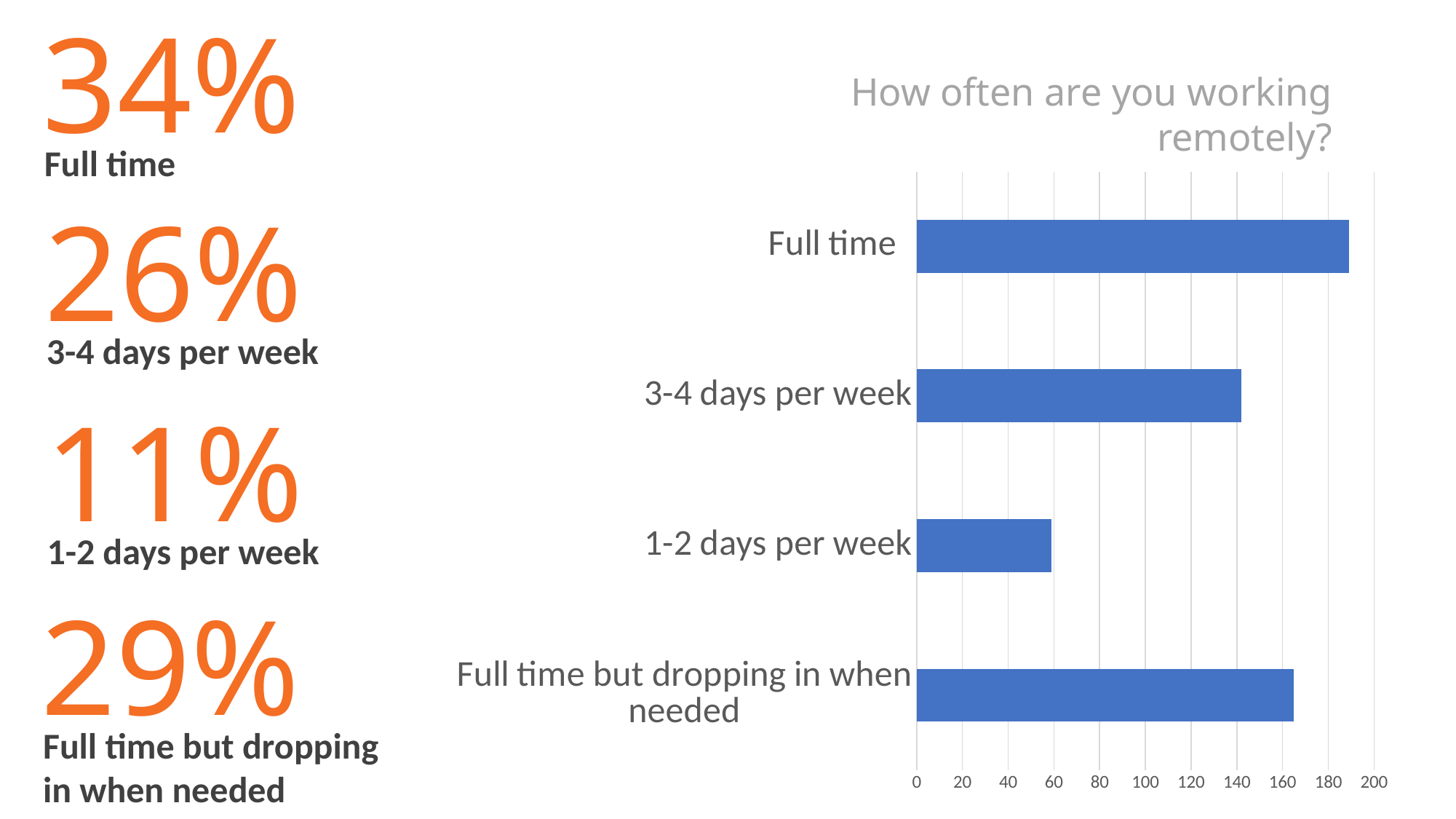
Is the value for 1-2 days per week greater or less than 80? less What is the title of the chart? How often are you working remotely? Is the value for Full time greater or less than 180? greater Which is larger, the value for Full time or the value for 3-4 days per week? Full time Is the value for 3-4 days per week greater or less than 120? greater What is the maximum value shown on the chart's horizontal axis? 200 How many categories does the chart show? 4 Which is larger, the value for Full time but dropping in when needed or the value for 1-2 days per week? Full time but dropping in when needed Which category has the lowest value in the chart? 1-2 days per week What kind of chart is shown on the slide? bar chart Which category has the highest value in the chart? Full time